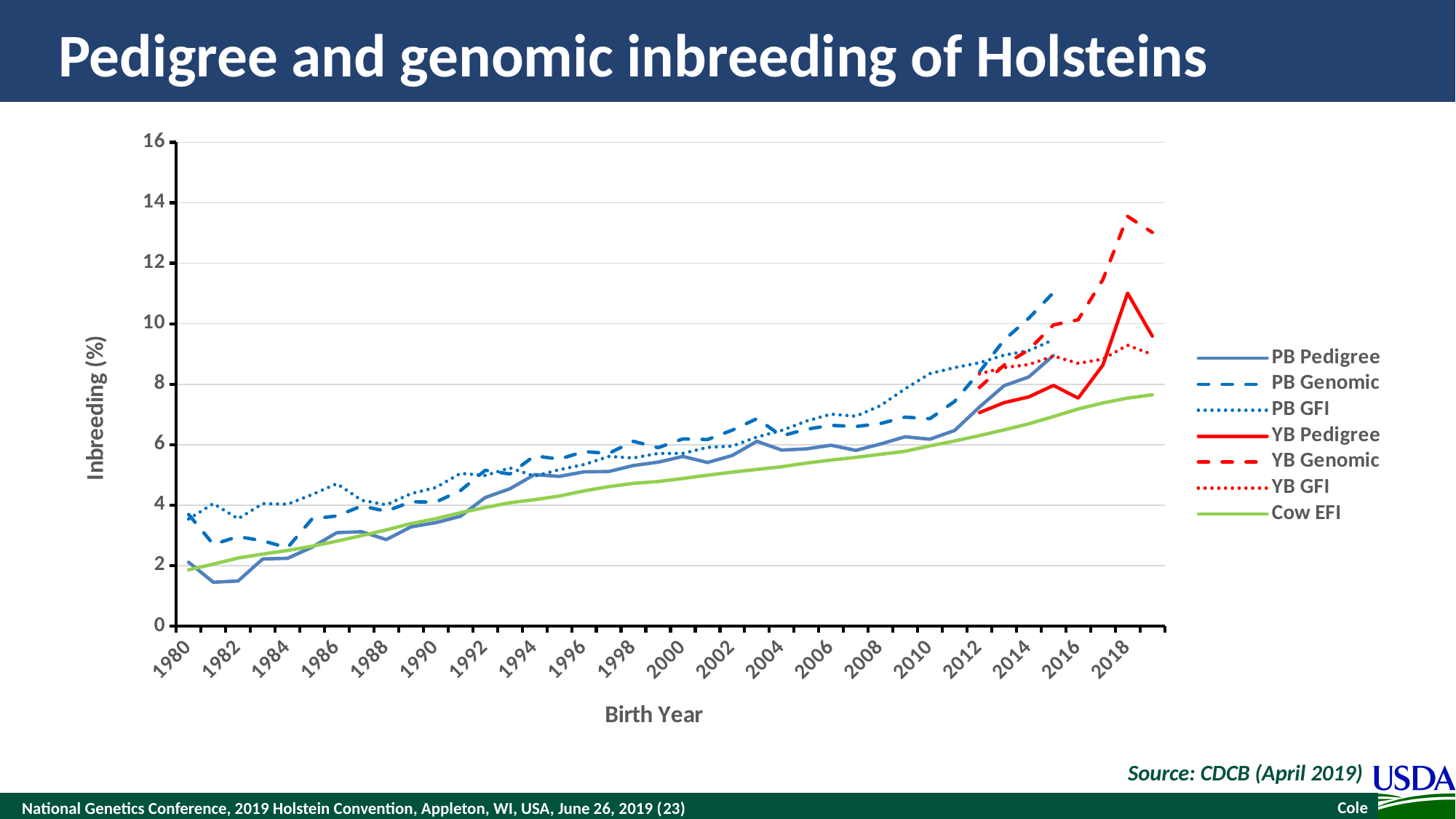
What kind of chart is shown on the slide? line chart What is the title of the chart? Pedigree and genomic inbreeding of Holsteins Is the value for YB Genomic in 2018 greater or less than 12? greater How many series does the legend list? 7 Does the Cow EFI line rise or fall as birth year increases from 1980 to 2018? rises Is the value for PB Pedigree in 1982 greater or less than 2? less In 2018, which is larger: YB Genomic or Cow EFI? YB Genomic What is the label of the x axis? Birth Year In 2010, which is larger: PB GFI or Cow EFI? PB GFI Does the PB Pedigree line generally rise or fall from 1980 to its last point? rises Which series reaches the highest value anywhere on the chart? YB Genomic Is the value for Cow EFI in 2018 greater or less than 8? less